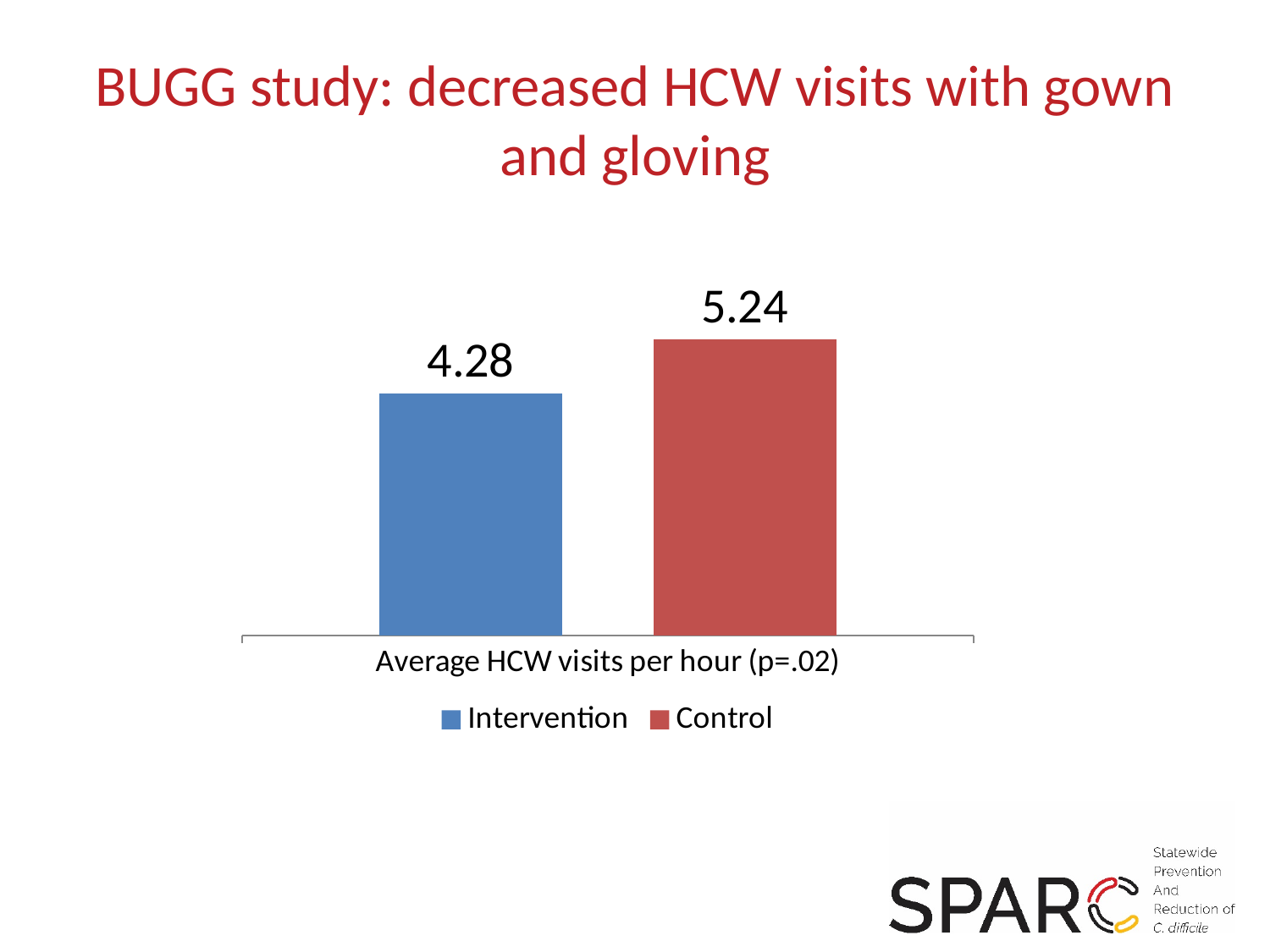
What kind of chart is shown on the slide? bar chart Which series has the higher average HCW visits per hour? Control What colour is the Control bar? red Which series has the lower average HCW visits per hour? Intervention Is the value for Intervention larger or smaller than the value for Control? smaller What is the value for Control in the chart? 5.24 How many series does the legend list? 2 What is the value for Intervention in the chart? 4.28 What is the difference between the Control and Intervention values? 0.96 How many bars are plotted in the chart? 2 What is the category label shown on the x axis? Average HCW visits per hour (p=.02)